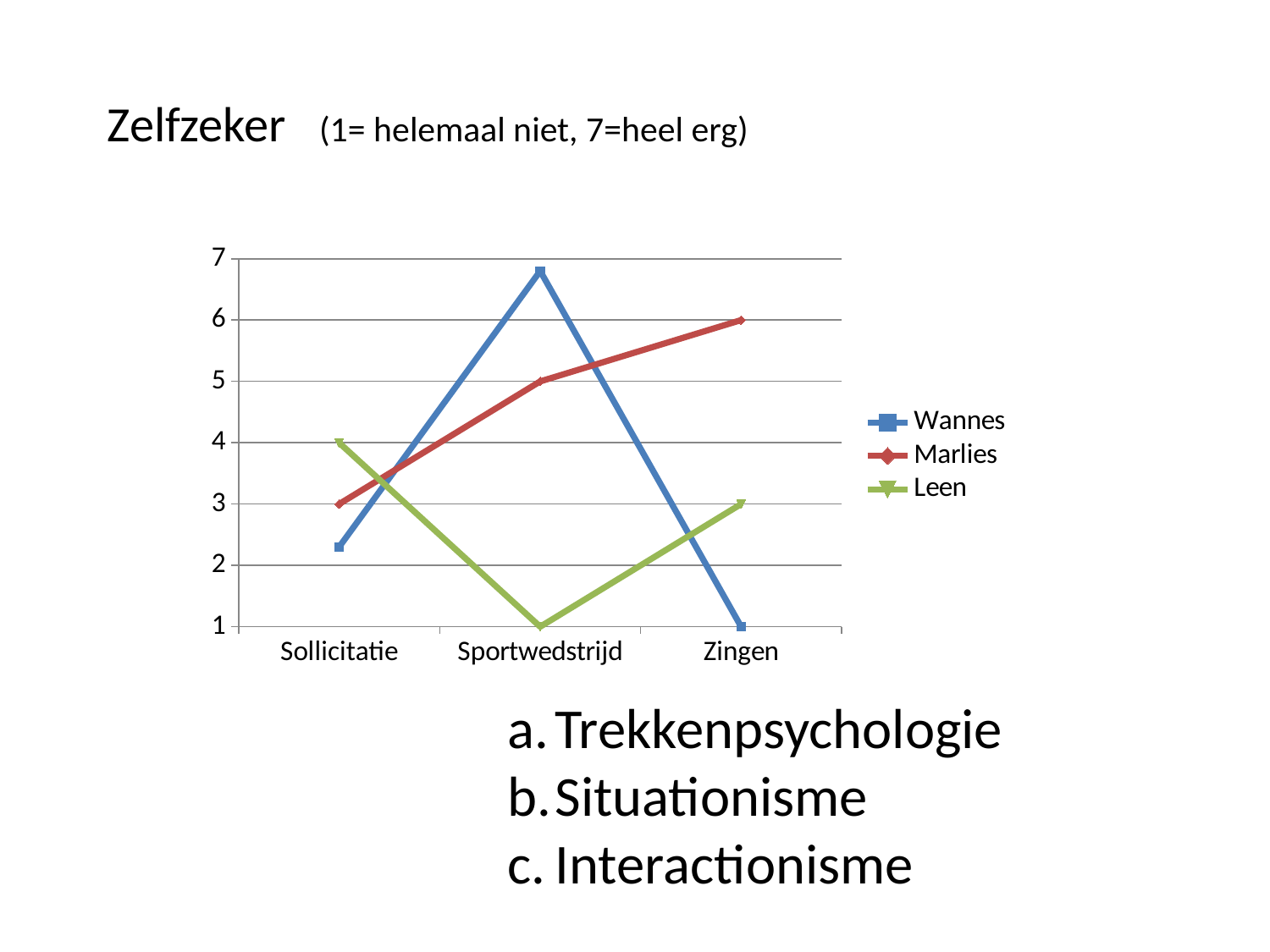
Which series has the highest value at Sportwedstrijd? Wannes Do the values for Marlies rise or fall from Sollicitatie to Zingen? rise What is the value for Leen at Sportwedstrijd? 1 What kind of chart is shown on the slide? line chart Is the value for Wannes at Sportwedstrijd greater or less than 6? greater How many series does the legend list? 3 How many categories are shown on the x axis? 3 What is the value for Marlies at Zingen? 6 What is the difference between Marlies and Leen at Zingen? 3 What is the value for Marlies at Sollicitatie? 3 What is the value for Leen at Sollicitatie? 4 Which series has the lowest value at Zingen? Wannes